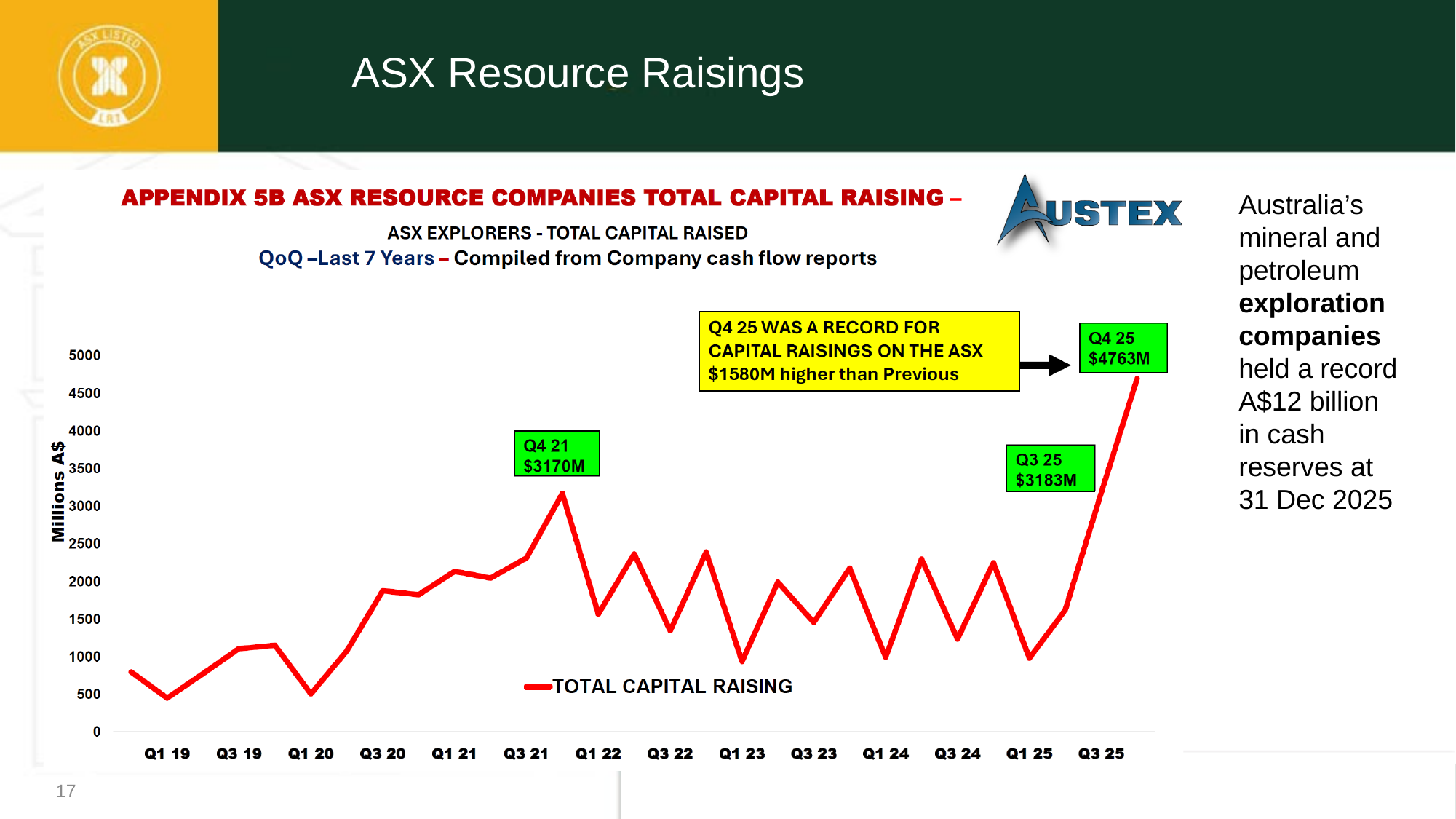
Is the value for Q1 19 greater or less than 1000? less What is the value for Q3 25 on the chart? $3183M What is the difference between the Q4 25 value and the Q3 25 value? $1580M Is the value for Q3 20 greater or less than 1500? greater Which is larger, the value for Q3 25 or the value for Q4 21? Q3 25 What is the value for Q4 25 on the chart? $4763M What kind of chart is shown on the slide? line chart How many series does the legend list? 1 What is the label on the vertical axis of the chart? Millions A$ Which quarter has the highest total capital raising on the chart? Q4 25 What is the value for Q4 21 on the chart? $3170M What is the difference between the Q4 25 value and the Q4 21 value? $1593M